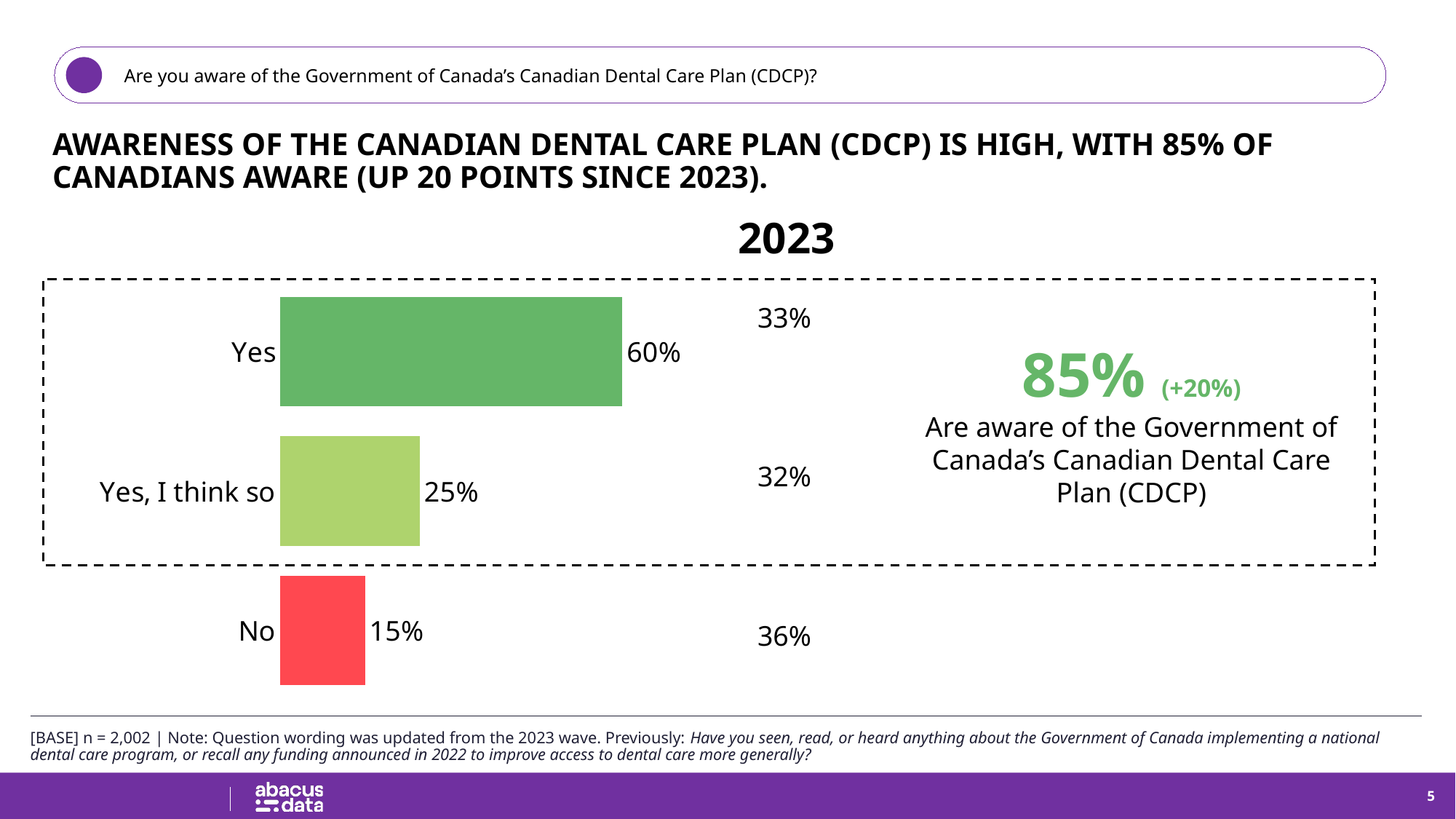
What percentage of respondents answered "Yes" in the bar chart? 60% What percentage of respondents answered "No" in the bar chart? 15% Which response category has the lowest value in the bar chart? No Which is larger in the bar chart: the value for "Yes, I think so" or the value for "No"? Yes, I think so Which response category has the highest value in the bar chart? Yes What colour is the bar for the "No" response? Red What is the difference between the "Yes" and "No" values in the bar chart? 45 percentage points What percentage of respondents answered "Yes, I think so" in the bar chart? 25% How many response categories are shown in the bar chart? 3 What kind of chart is shown on the slide? Bar chart What is the difference between the "Yes" and "Yes, I think so" values in the bar chart? 35 percentage points What was the 2023 value shown for the "No" response? 36%